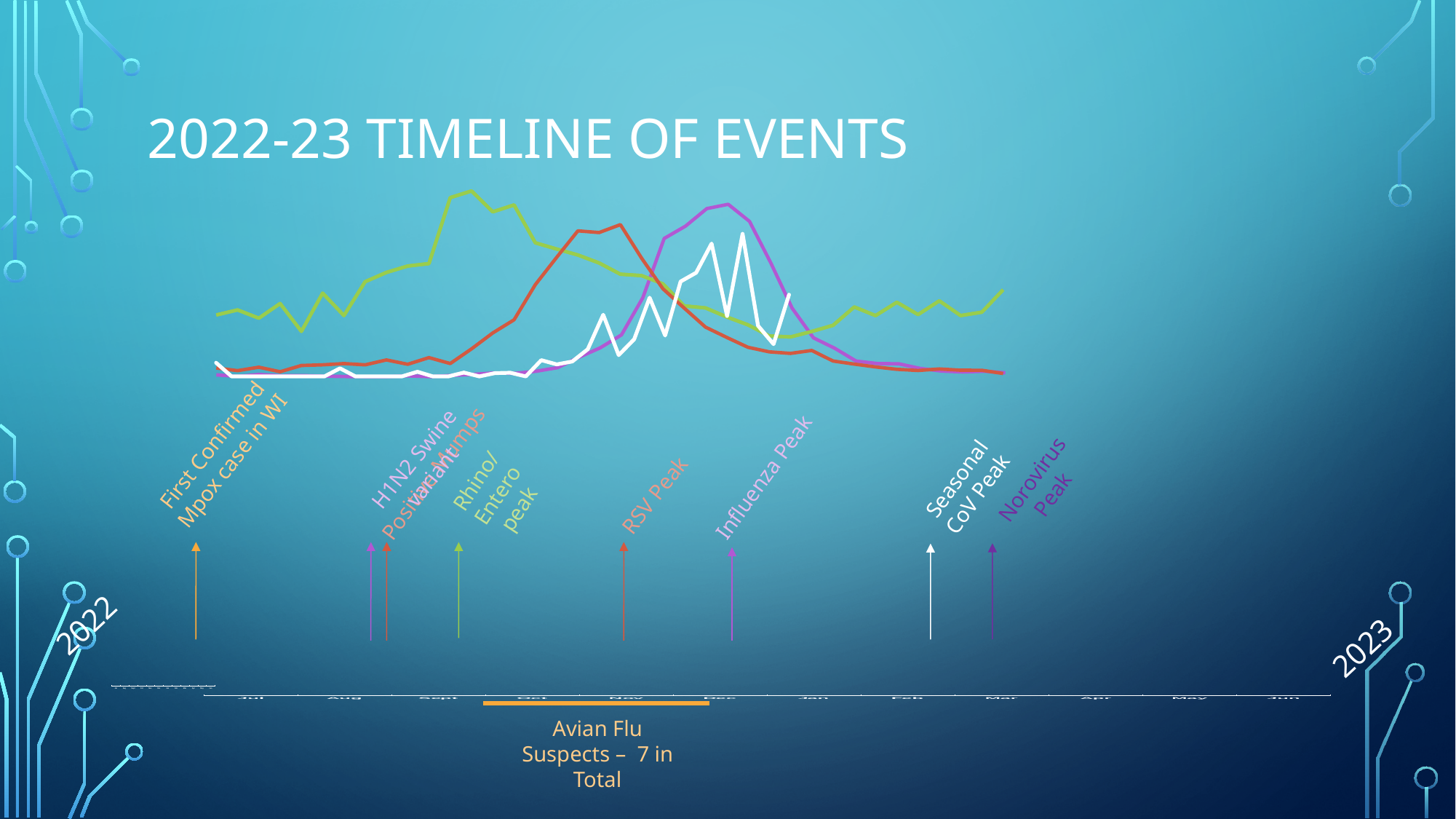
What is the title of the slide containing the chart? 2022-23 Timeline of Events Which coloured line is highest at the Nov mark? orange How many lines are plotted on the chart? 4 How many Avian Flu suspects in total are noted under the timeline? 7 How many month labels are shown along the x axis? 12 What kind of chart is shown on the slide? line chart Which coloured line reaches its peak earliest along the x axis? green Does the purple line rise or fall between Oct and Dec? rise Which month label appears last on the x axis? Jun Does the green line rise or fall between Sept and Dec? fall Which month label appears first on the x axis? Jul Does the orange line rise or fall between Nov and Jan? fall